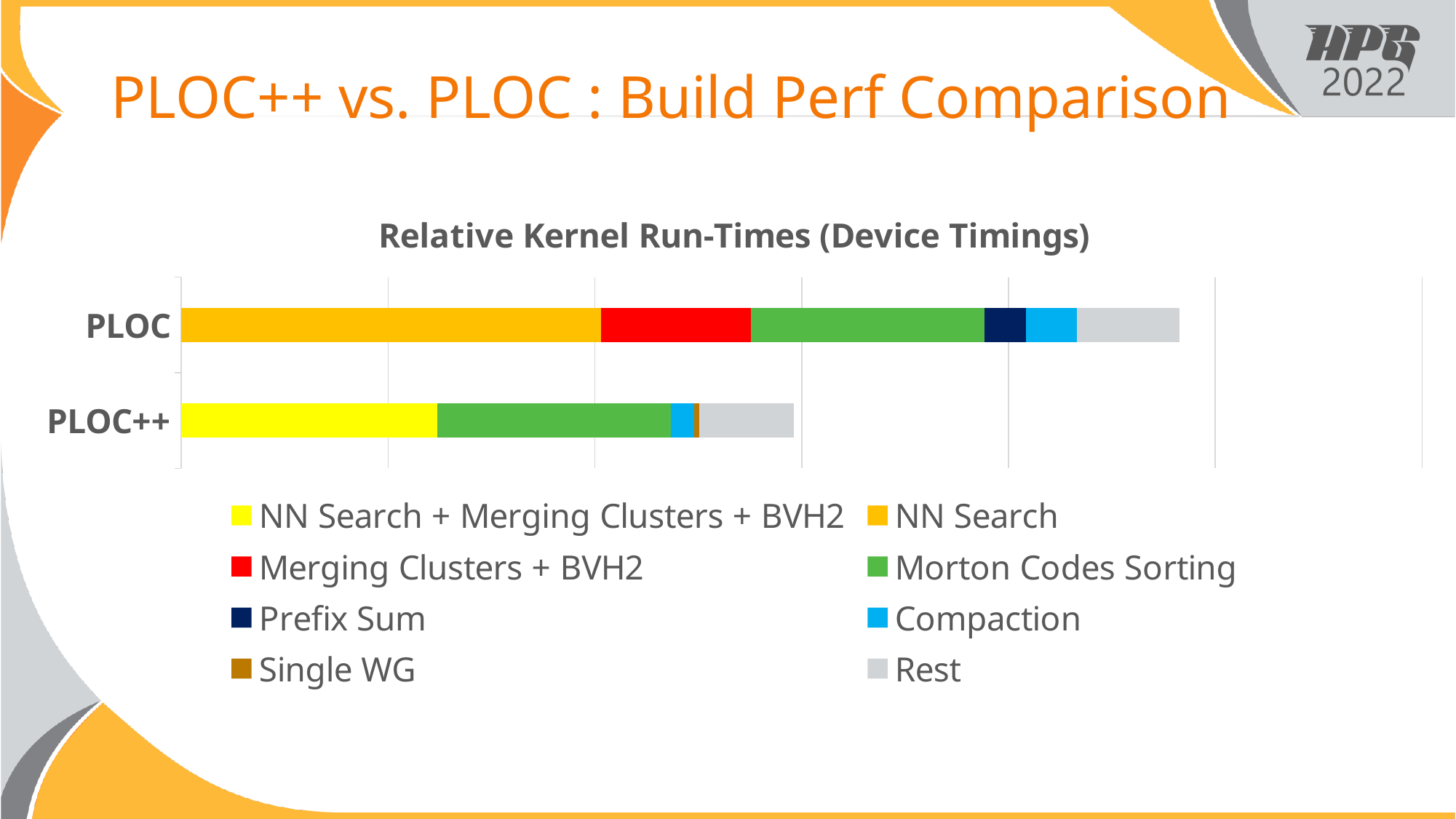
Which series takes up the largest segment of the PLOC++ bar? NN Search + Merging Clusters + BVH2 Which colour represents Morton Codes Sorting in the legend? Green Which bar has the longer total run-time, PLOC or PLOC++? PLOC How many series does the legend list? 8 How many bars (categories) does the chart show? 2 Which category has the longest total bar? PLOC What kind of chart is shown on the slide? Stacked bar chart Which category has the shortest total bar? PLOC++ What is the title of the chart? Relative Kernel Run-Times (Device Timings) Which series appears in the PLOC bar but not in the PLOC++ bar: Prefix Sum or Compaction? Prefix Sum Which series takes up the largest segment of the PLOC bar? NN Search Is the Morton Codes Sorting segment longer in the PLOC bar or the PLOC++ bar? Neither; the Morton Codes Sorting segment is the same length in both bars